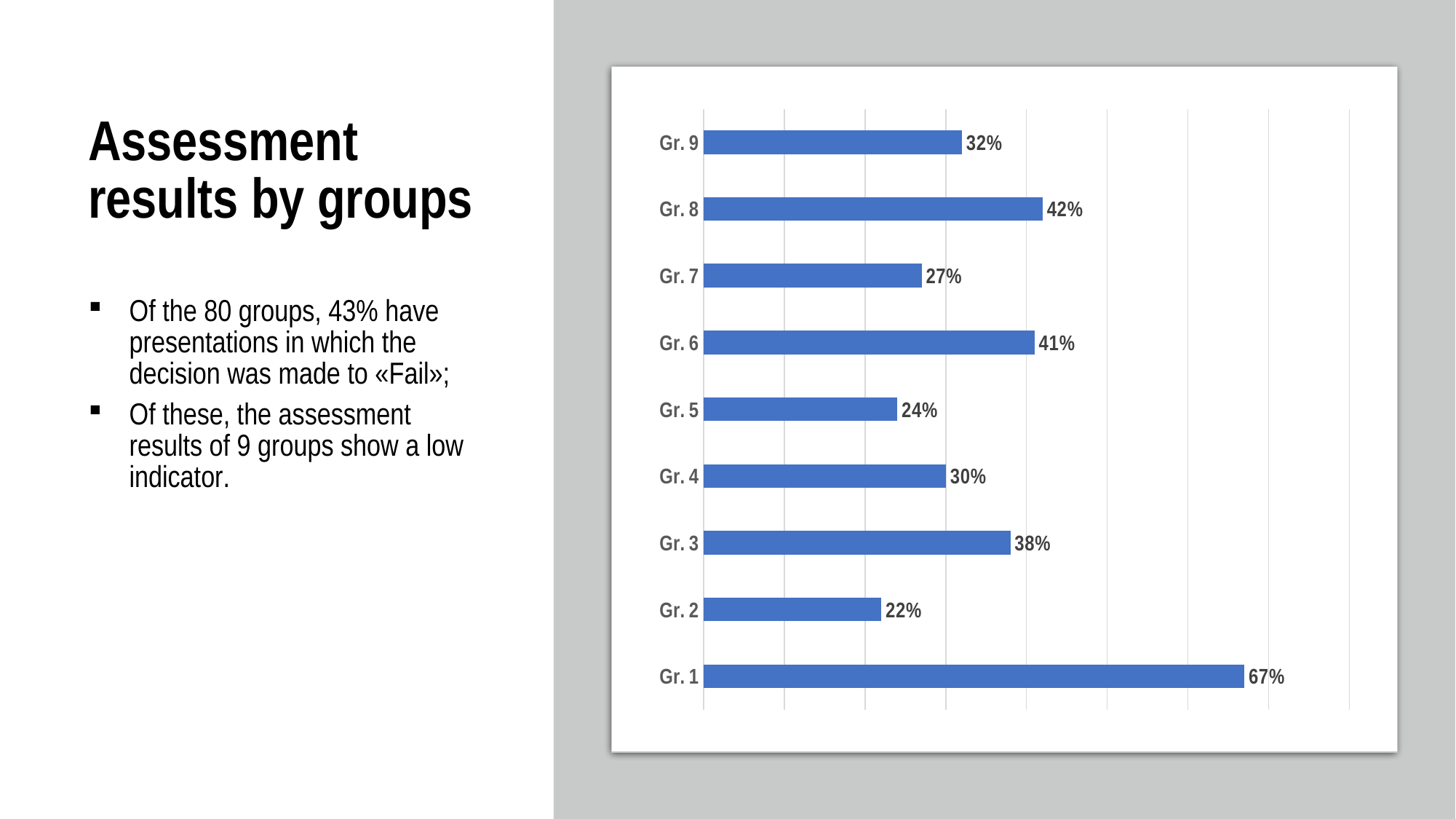
What is the difference between the values for Gr. 8 and Gr. 7? 15% What is the value for Gr. 1? 67% Which group has the highest value? Gr. 1 Which is larger, the value for Gr. 3 or the value for Gr. 4? Gr. 3 How many groups are shown in the chart? 9 What colour are the bars in the chart? Blue What is the value for Gr. 5? 24% Which group has the lowest value? Gr. 2 What is the difference between the values for Gr. 1 and Gr. 2? 45% What kind of chart is shown on the slide? Bar chart What is the value for Gr. 8? 42% Which is larger, the value for Gr. 9 or the value for Gr. 6? Gr. 6